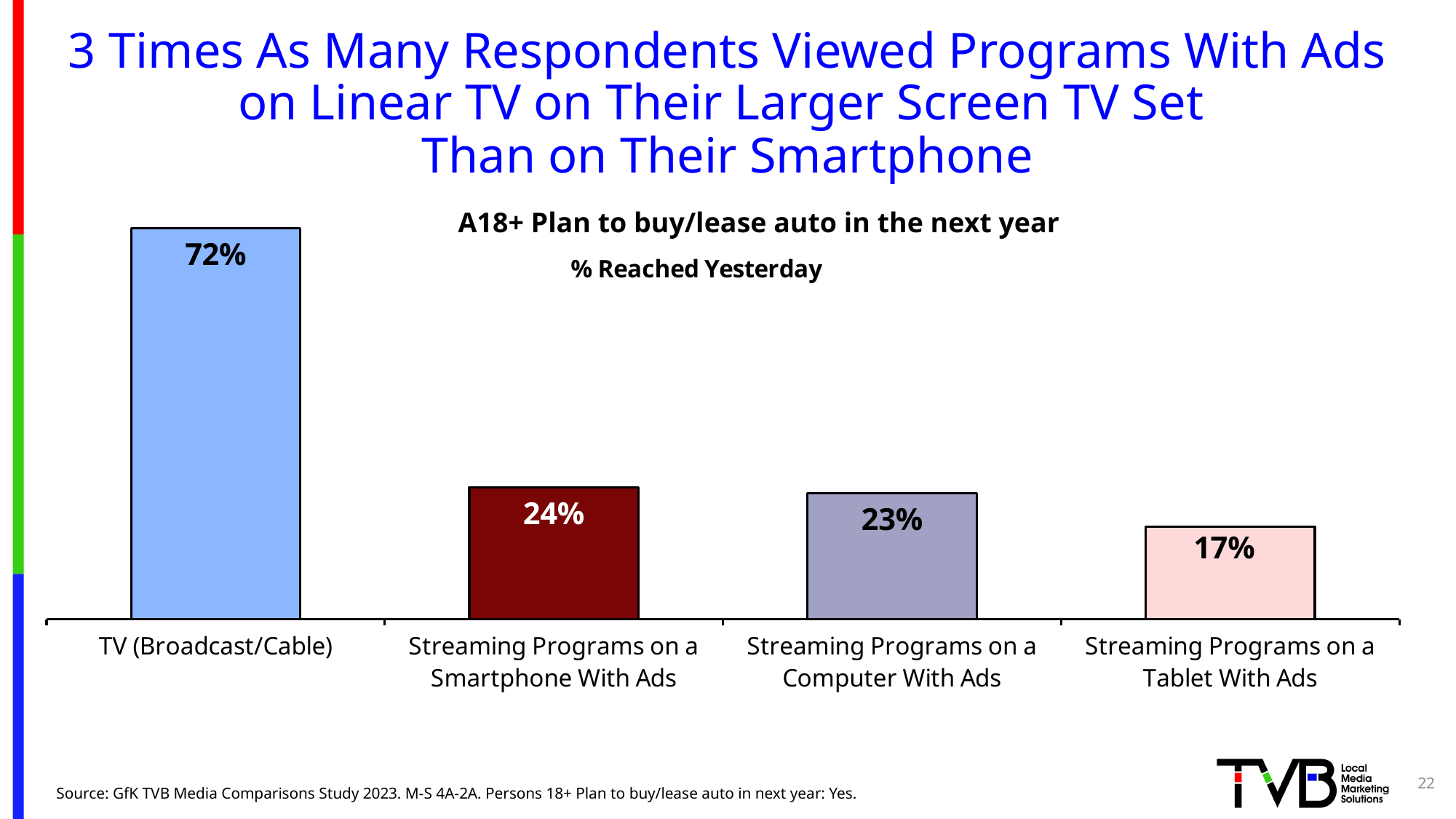
What is the title of the chart? % Reached Yesterday What is the value for Streaming Programs on a Smartphone With Ads? 24% Which is larger: the value for Streaming Programs on a Smartphone With Ads or Streaming Programs on a Tablet With Ads? Streaming Programs on a Smartphone With Ads What is the difference between the values for Streaming Programs on a Computer With Ads and Streaming Programs on a Tablet With Ads? 6% Which category has the highest % Reached Yesterday? TV (Broadcast/Cable) What is the value for Streaming Programs on a Computer With Ads? 23% How many categories are shown in the chart? 4 What is the difference between the values for TV (Broadcast/Cable) and Streaming Programs on a Smartphone With Ads? 48% What is the % Reached Yesterday value for TV (Broadcast/Cable)? 72% Which category has the lowest % Reached Yesterday? Streaming Programs on a Tablet With Ads What is the value for Streaming Programs on a Tablet With Ads? 17% What kind of chart is shown on the slide? Bar chart